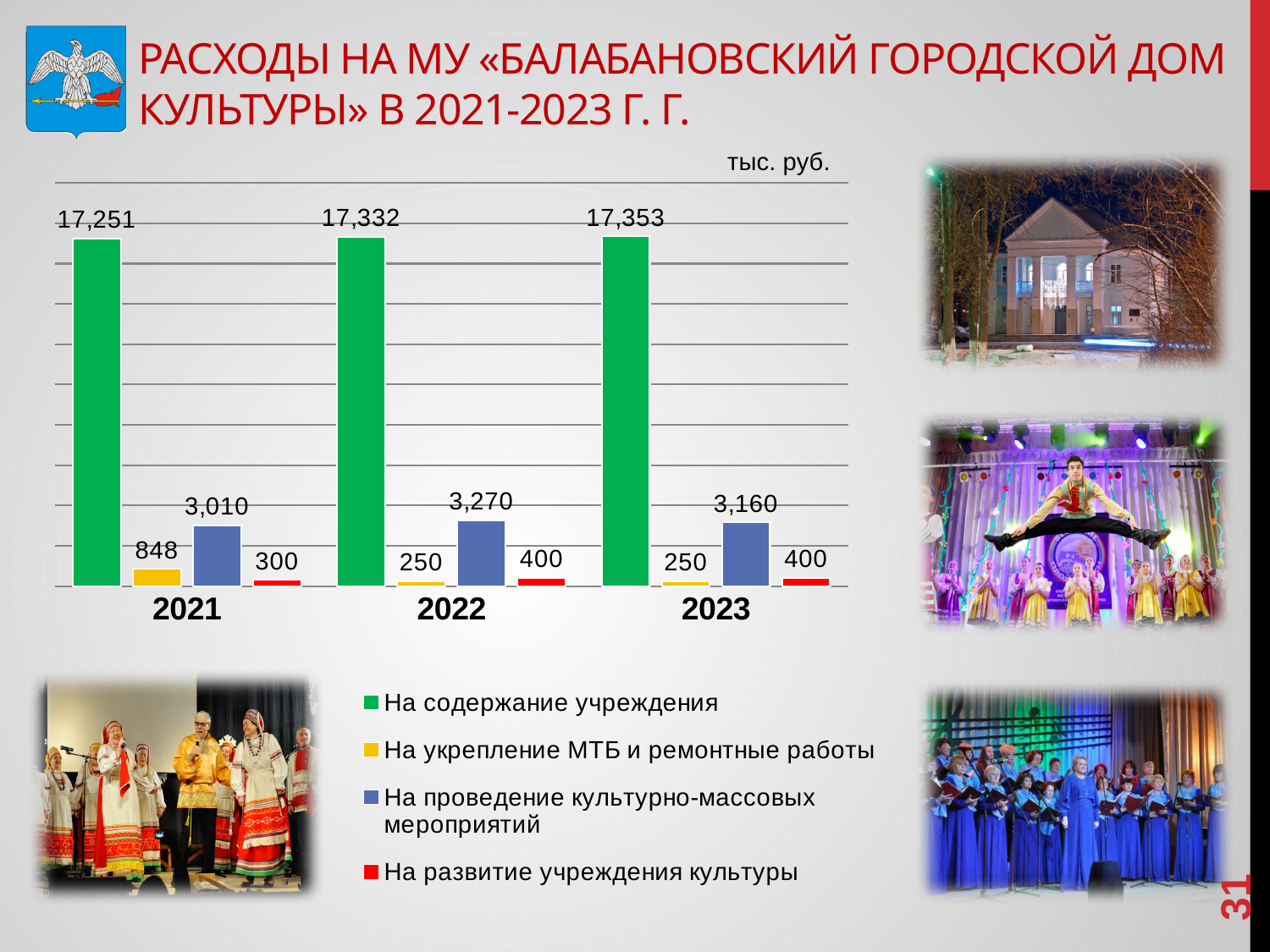
What is the value for «На укрепление МТБ и ремонтные работы» in 2021? 848 Which is larger: «На укрепление МТБ и ремонтные работы» in 2021 or in 2022? 2021 In which year is the value for «На содержание учреждения» lowest? 2021 What is the difference between the 2023 and 2021 values for «На содержание учреждения»? 102 What is the value for «На проведение культурно-массовых мероприятий» in 2023? 3,160 In which year is the value for «На проведение культурно-массовых мероприятий» highest? 2022 Does the value for «На содержание учреждения» rise or fall from 2021 to 2023? rise What is the value for «На развитие учреждения культуры» in 2021? 300 What type of chart is shown on the slide? bar chart What is the value for «На содержание учреждения» in 2022? 17,332 How many years (categories) are shown on the x axis? 3 How many series does the legend list? 4